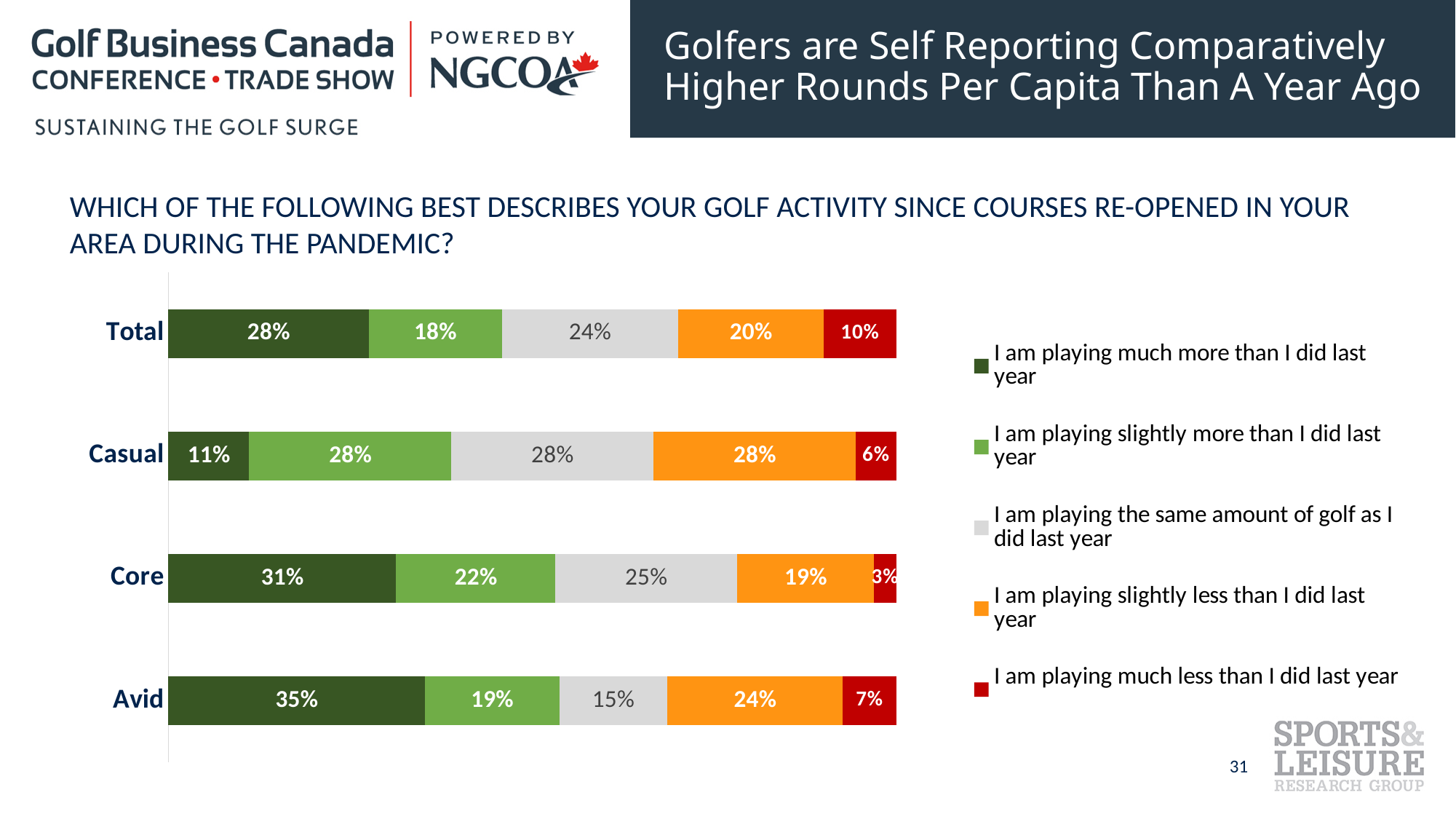
Which is larger: the share of Avid golfers playing slightly less than last year, or the share of Core golfers playing slightly less than last year? Avid What colour represents 'I am playing much less than I did last year'? Red What is the difference between the Avid and Casual shares saying they are playing much more than last year? 24 percentage points What percentage of Core golfers say they are playing the same amount of golf as last year? 25% What percentage of Casual golfers say they are playing much more than they did last year? 11% What percentage of Avid golfers say they are playing much more than they did last year? 35% Which group has the highest share saying they are playing much more than last year? Avid What type of chart is shown on the slide? Stacked bar chart What percentage of the Total group say they are playing much less than they did last year? 10% Which group has the lowest share saying they are playing much less than last year? Core How many groups (bars) are shown in the chart? 4 How many response categories does the legend list? 5